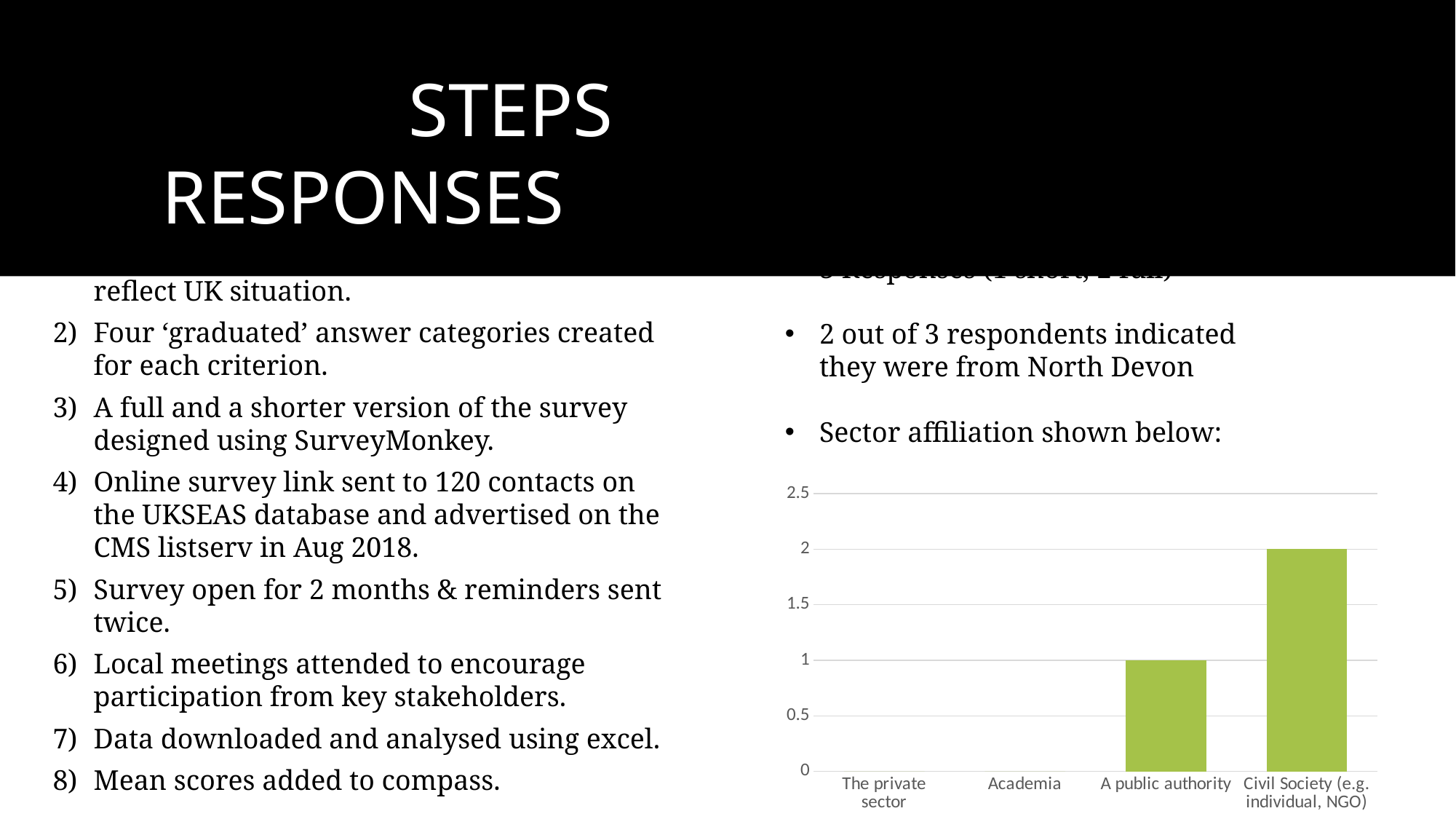
Is the value for Civil Society (e.g. individual, NGO) greater or less than 1.5? greater What kind of chart is shown on the slide? bar chart What colour are the bars in the chart? green What is the difference between the values for Civil Society (e.g. individual, NGO) and A public authority? 1 Which category has the highest value in the chart? Civil Society (e.g. individual, NGO) Which is larger in the chart: the value for A public authority or the value for Civil Society (e.g. individual, NGO)? Civil Society (e.g. individual, NGO) What is the value for A public authority in the chart? 1 What is the value for Civil Society (e.g. individual, NGO) in the chart? 2 Is the value for A public authority greater or less than 1.5? less Do the values in the chart rise or fall from left to right along the x axis? rise What is the highest value shown on the chart's vertical axis? 2.5 How many categories are shown on the x axis of the chart? 4